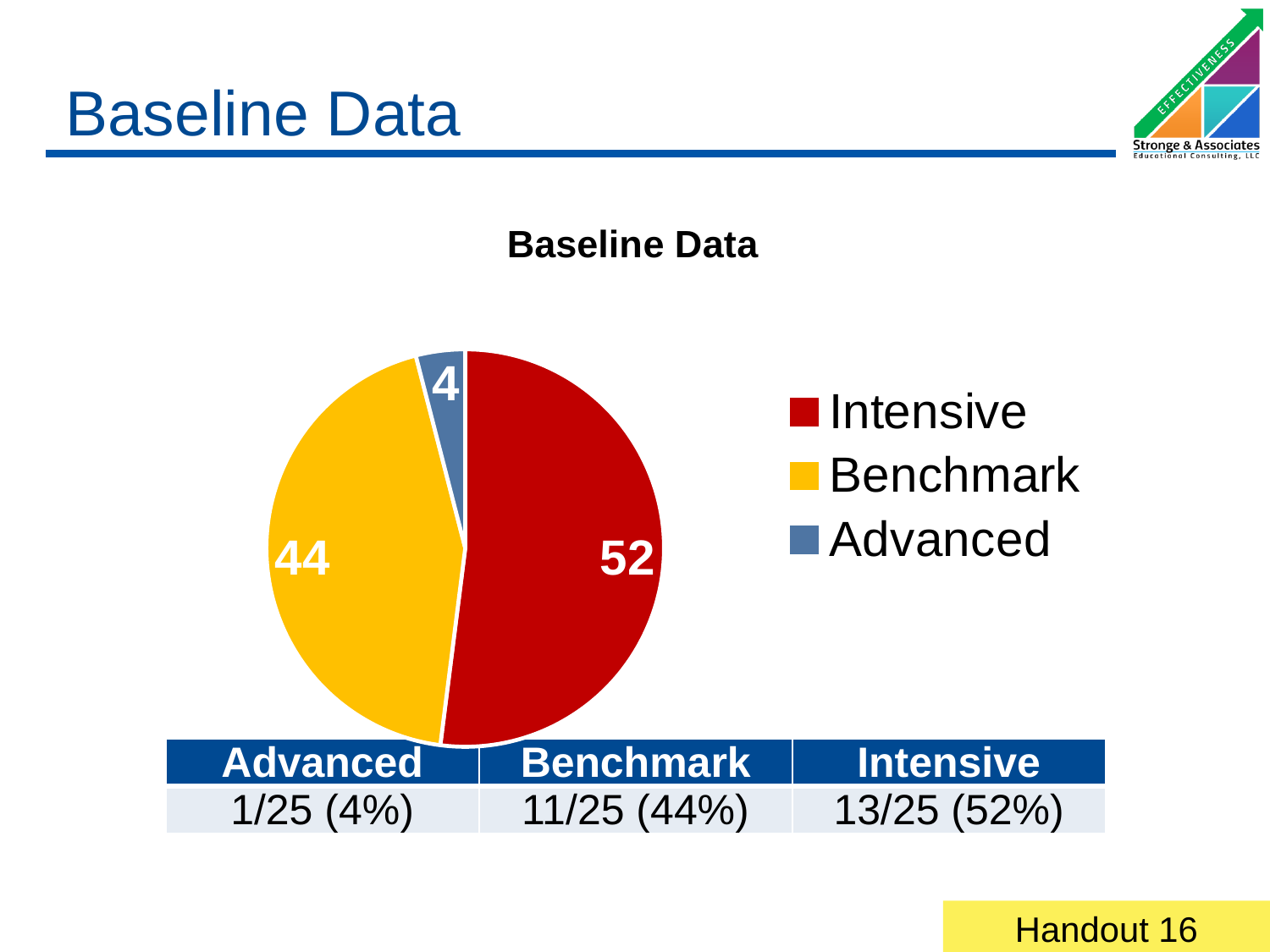
What is the difference between the Intensive and Benchmark values? 8 What value is labelled on the Advanced slice? 4 What colour is the Benchmark slice? yellow Which category has the largest slice? Intensive What value is labelled on the Intensive slice? 52 What value is labelled on the Benchmark slice? 44 How many categories does the pie chart show? 3 How many entries does the legend list? 3 What type of chart is shown on the slide? pie chart What is the chart's title? Baseline Data Which is larger, the Benchmark slice or the Advanced slice? Benchmark Which category has the smallest slice? Advanced